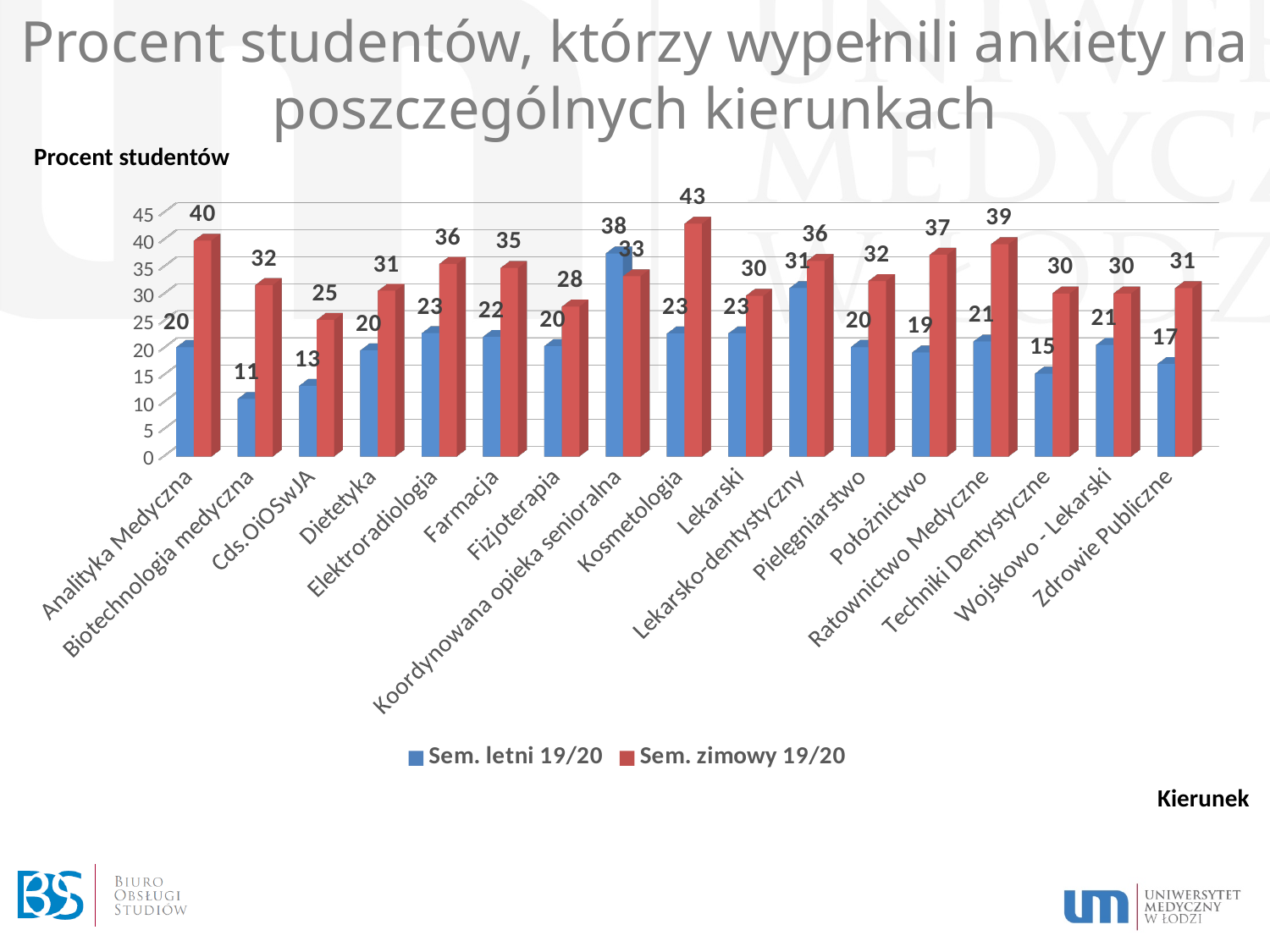
Which category has the lowest value in the Sem. letni 19/20 series? Biotechnologia medyczna Which category has the highest value in the Sem. zimowy 19/20 series? Kosmetologia Which is larger for Koordynowana opieka senioralna: the Sem. letni 19/20 value or the Sem. zimowy 19/20 value? Sem. letni 19/20 Which category has the lowest value in the Sem. zimowy 19/20 series? Cds.OiOSwJA How many categories (kierunki) are shown on the x axis? 17 Which colour represents the Sem. zimowy 19/20 series? Red What is the difference between the Sem. zimowy 19/20 and Sem. letni 19/20 values for Analityka Medyczna? 20 What kind of chart is shown on the slide? Bar chart What is the value for Koordynowana opieka senioralna in the Sem. letni 19/20 series? 38 How many series does the legend list? 2 What is the value for Kosmetologia in the Sem. zimowy 19/20 series? 43 What is the value for Położnictwo in the Sem. letni 19/20 series? 19